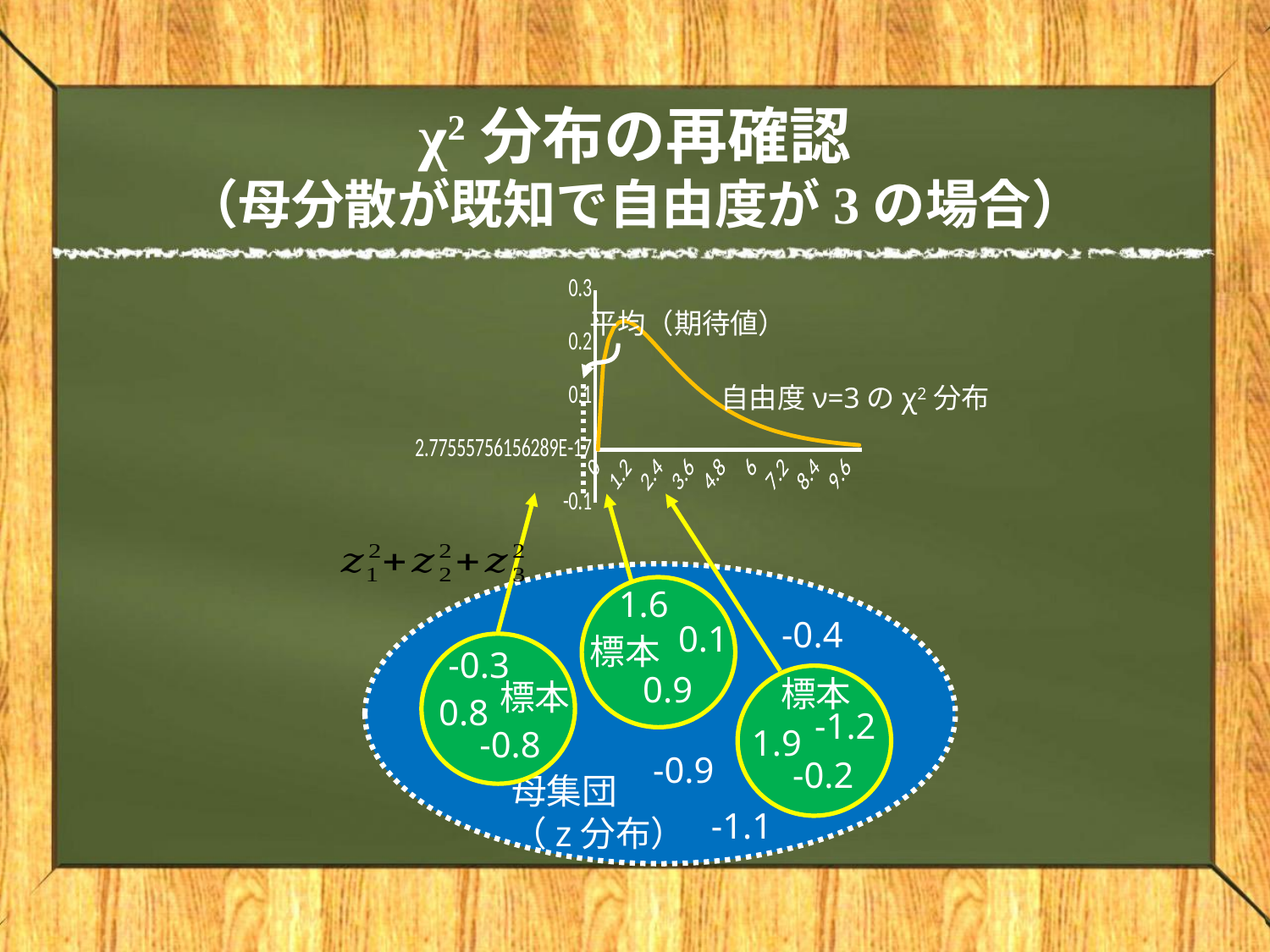
Is the value of the curve at x = 7.2 greater or less than 0.1? less What is the lowest value labelled on the vertical axis of the chart? -0.1 Is the value of the curve at x = 1.2 greater or less than 0.1? greater What kind of chart is shown on the slide? line chart What is the highest value labelled on the vertical axis of the chart? 0.3 Is the value of the curve at x = 9.6 greater or less than 0.1? less Which is larger, the value of the curve at x = 1.2 or at x = 8.4? 1.2 How many tick labels are shown along the horizontal axis of the chart? 9 What degrees of freedom (ν) does the chart's annotation say the χ² distribution has? 3 What is the largest tick label on the horizontal axis of the chart? 9.6 Does the curve rise or fall as x increases from 2.4 to 9.6? fall